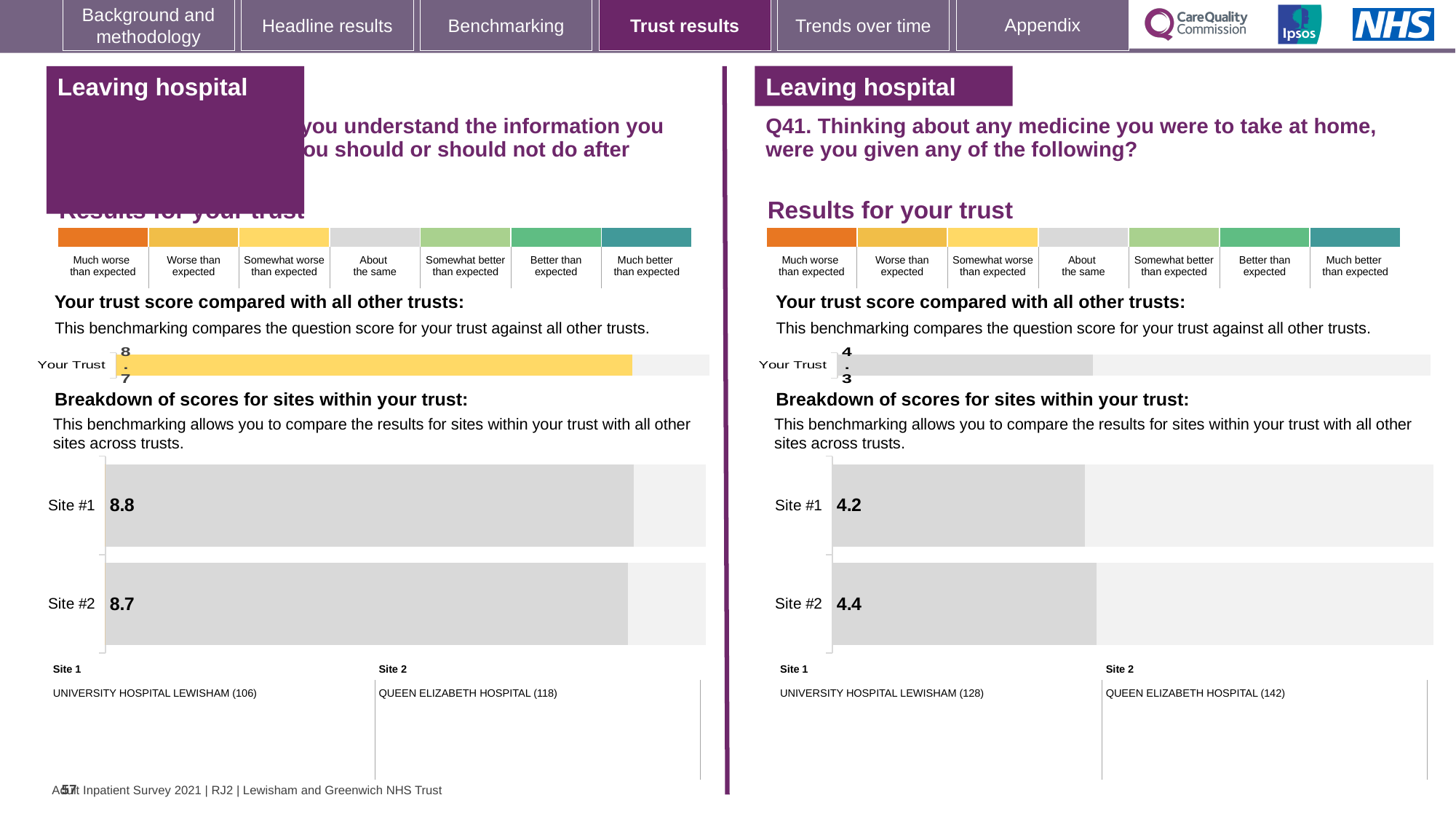
On the right-hand chart (Q41), what is the score for Your Trust? 4.3 How many sites are shown in the right-hand (Q41) site breakdown chart? 2 In the right-hand (Q41) site breakdown chart, what is the score for Site #2? 4.4 In the left-hand site breakdown chart, which site has the lower score? Site #2 In the left-hand site breakdown chart, what is the score for Site #2? 8.7 In the right-hand (Q41) site breakdown chart, which site has the higher score? Site #2 In the right-hand (Q41) site breakdown chart, what is the score for Site #1? 4.2 On the left-hand chart, what is the score for Your Trust? 8.7 In the right-hand (Q41) site breakdown chart, what is the difference between the Site #2 and Site #1 scores? 0.2 In the left-hand site breakdown chart, what is the difference between the Site #1 and Site #2 scores? 0.1 In the left-hand site breakdown chart, what is the score for Site #1? 8.8 What type of chart is used for the site breakdown on the left-hand side of the slide? Bar chart